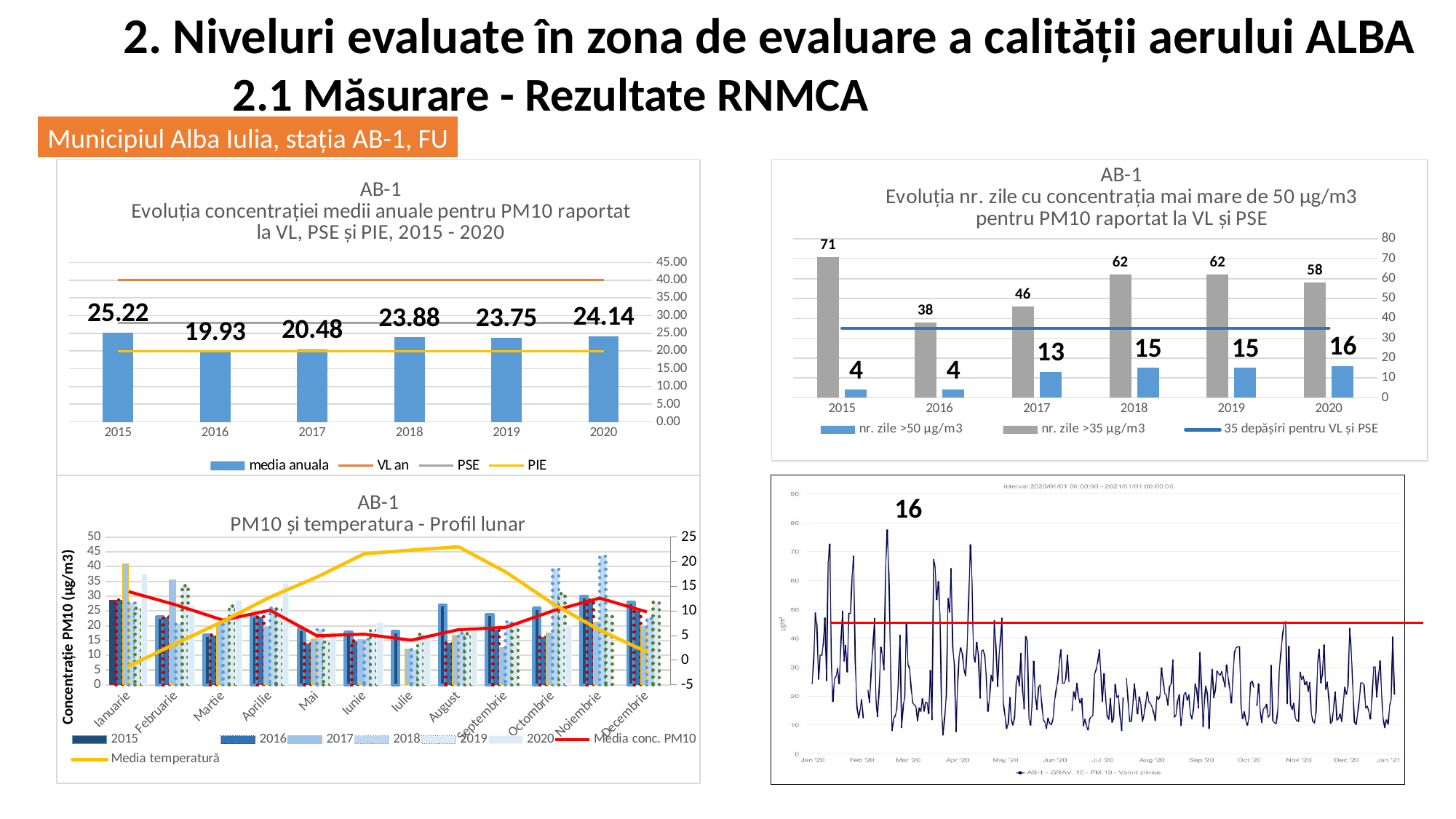
In the top-left chart 'Evoluția concentrației medii anuale pentru PM10', how many series does the legend list? 4 In the top-left chart 'Evoluția concentrației medii anuale pentru PM10', which year has the highest annual mean? 2015 What kind of chart is the bottom-right chart showing daily PM10 values for 2020? line chart In the top-right chart 'Evoluția nr. zile cu concentrația mai mare de 50 µg/m3', is the number of days above 35 µg/m3 in 2018 greater or less than the number in 2020? greater In the top-left chart 'Evoluția concentrației medii anuale pentru PM10', which year has the lowest annual mean? 2016 In the top-left chart 'Evoluția concentrației medii anuale pentru PM10', what is the difference between the 2015 and 2020 values? 1.08 In the top-left chart 'Evoluția concentrației medii anuale pentru PM10', what is the annual mean value for 2016? 19.93 In the top-right chart 'Evoluția nr. zile cu concentrația mai mare de 50 µg/m3', how many years are shown on the x axis? 6 In the top-right chart 'Evoluția nr. zile cu concentrația mai mare de 50 µg/m3', how many days exceeded 50 µg/m3 in 2017? 13 In the top-right chart 'Evoluția nr. zile cu concentrația mai mare de 50 µg/m3', which year has the highest number of days above 35 µg/m3? 2015 In the top-right chart 'Evoluția nr. zile cu concentrația mai mare de 50 µg/m3', what is the difference between the number of days above 35 µg/m3 in 2015 and 2016? 33 In the bottom-left chart 'PM10 și temperatura - Profil lunar', how many series does the legend list? 8